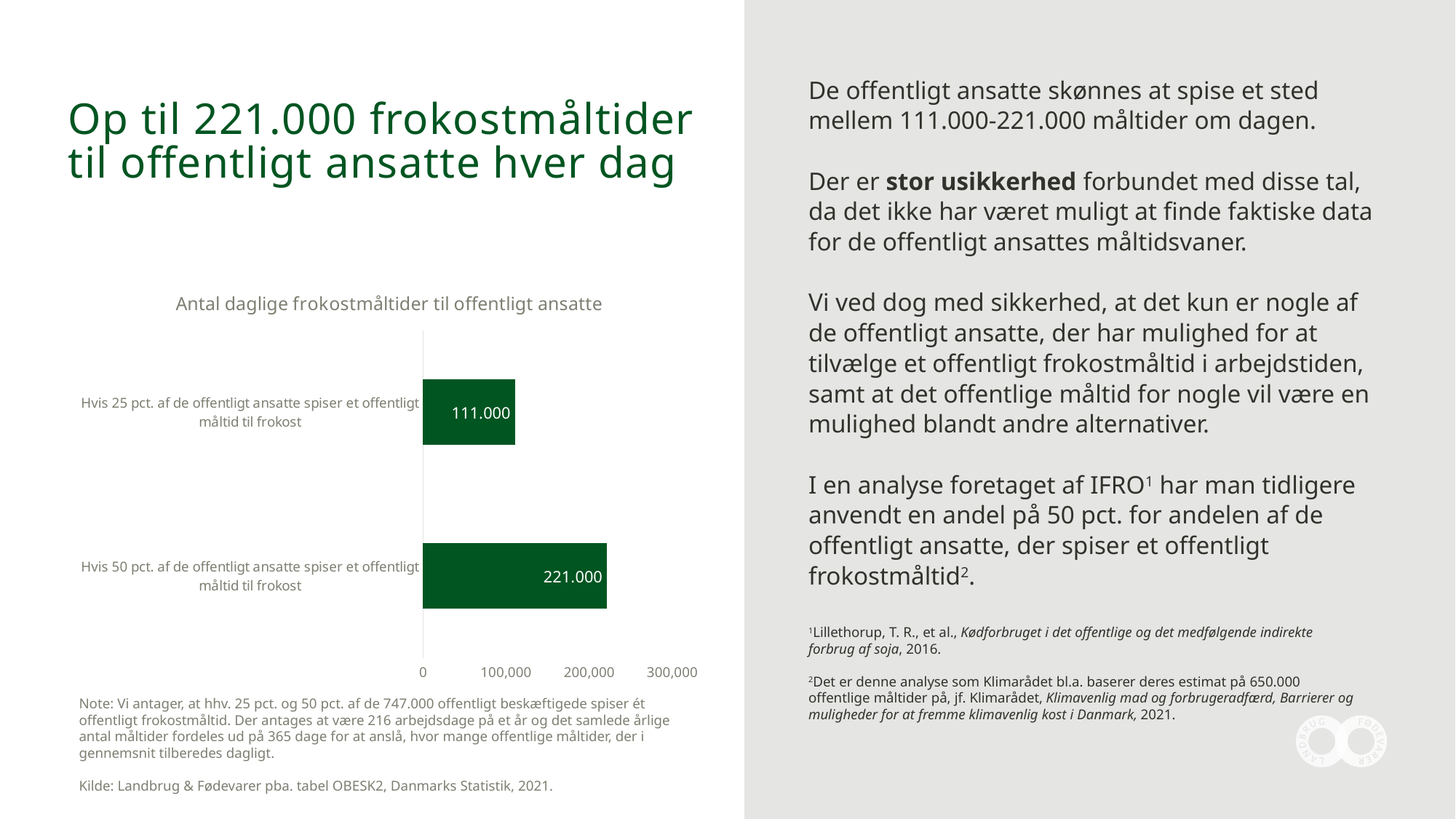
What is the difference between the 50 pct. scenario and the 25 pct. scenario? 110.000 What is the highest tick value shown on the x axis? 300,000 Which category has the lowest value? Hvis 25 pct. af de offentligt ansatte spiser et offentligt måltid til frokost Is the value for the 25 pct. scenario greater or less than 200,000? less Which is larger: the value for the 25 pct. scenario or the 50 pct. scenario? The 50 pct. scenario What kind of chart is shown on the slide? Bar chart How many categories are shown in the chart? 2 What is the title of the chart? Antal daglige frokostmåltider til offentligt ansatte Is the value for the 50 pct. scenario greater or less than 200,000? greater What is the value for 'Hvis 25 pct. af de offentligt ansatte spiser et offentligt måltid til frokost'? 111.000 Which category has the highest value? Hvis 50 pct. af de offentligt ansatte spiser et offentligt måltid til frokost What is the value for 'Hvis 50 pct. af de offentligt ansatte spiser et offentligt måltid til frokost'? 221.000